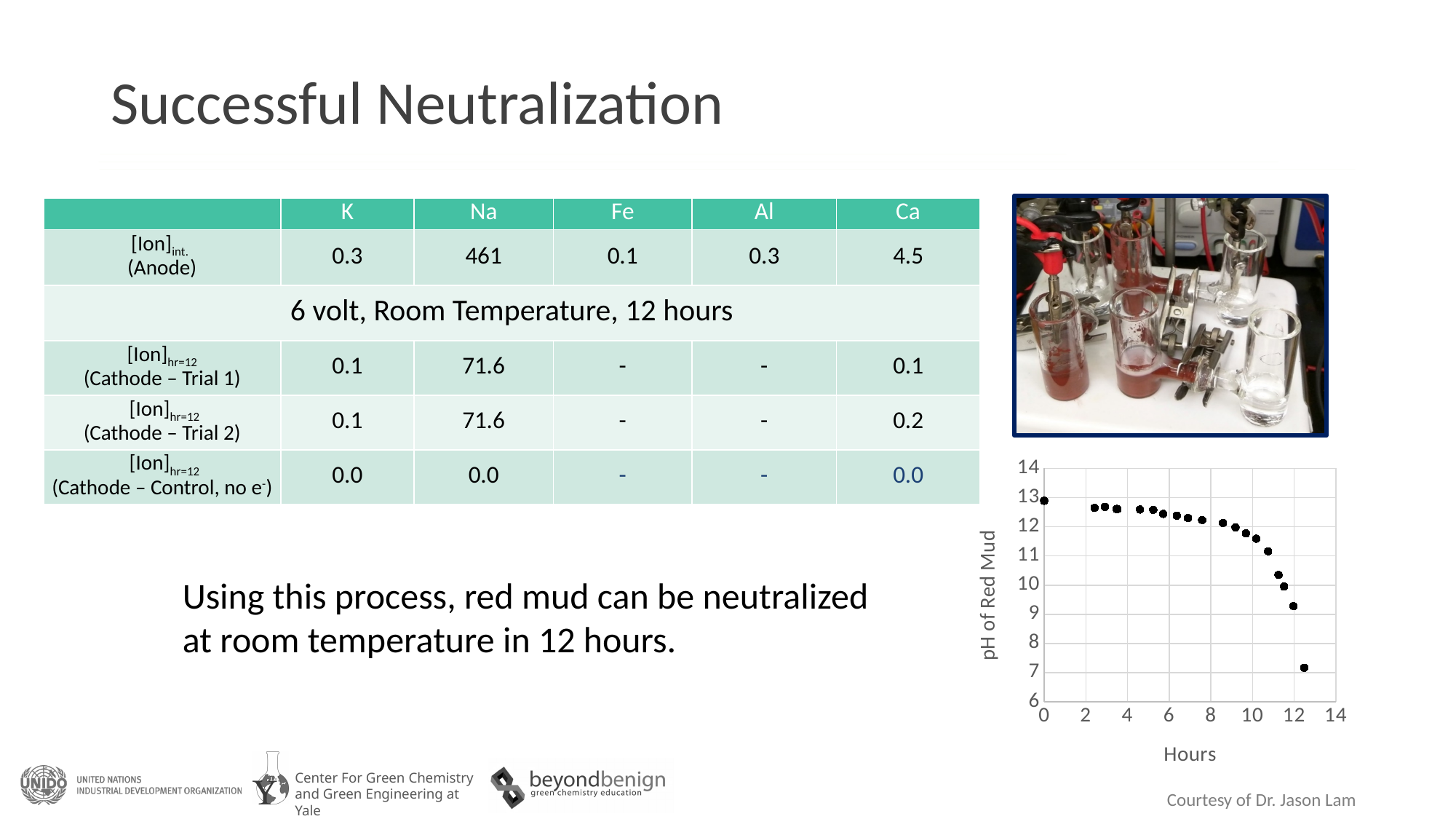
In the pH chart, is the pH at 0 hours greater or less than 12? greater In the pH chart, is the pH at 8 hours greater or less than 11? greater What kind of chart is shown at the bottom right of the slide? Scatter chart What is the label of the y axis of the pH chart? pH of Red Mud In the pH chart, is the pH at the final point (around 12.5 hours) greater or less than 8? less In the pH chart, which is larger: the pH at 0 hours or the pH at 12 hours? 0 hours What is the label of the x axis of the pH chart? Hours In the pH chart, does the pH of red mud rise or fall as the hours increase? Fall In the pH chart, at which time is the pH of red mud highest? 0 hours In the pH chart, is the lowest pH at the start or the end of the time series? The end